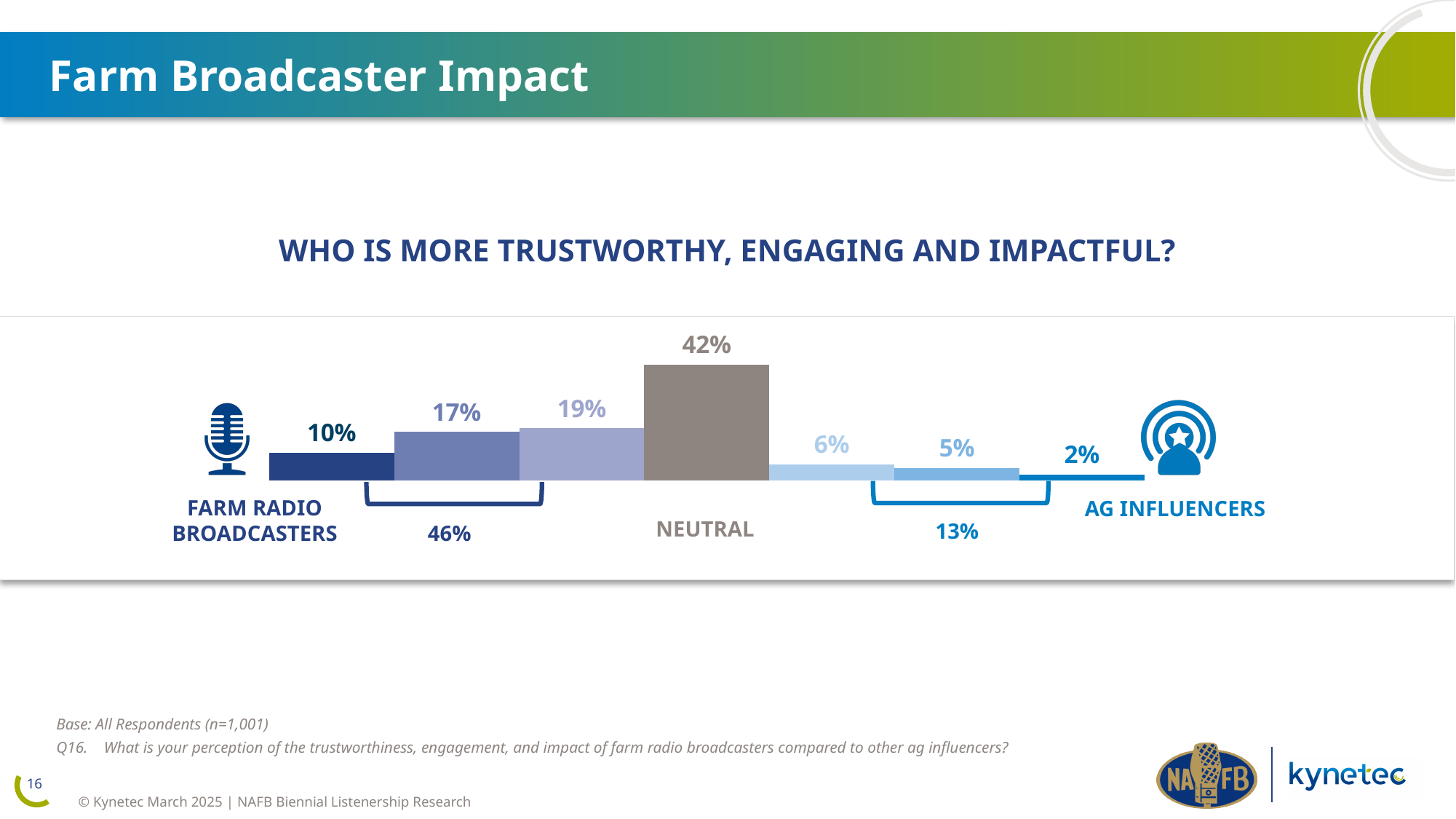
Which side has the larger combined share: Farm Radio Broadcasters or Ag Influencers? Farm Radio Broadcasters What kind of chart is shown on the slide? Bar chart Which bar has the highest value? Neutral (42%) What is the title of the chart? WHO IS MORE TRUSTWORTHY, ENGAGING AND IMPACTFUL? What is the value of the bar closest to the Farm Radio Broadcasters label? 10% What combined percentage leans toward Farm Radio Broadcasters, as shown by the bracket on the left? 46% How many bars are plotted in the chart? 7 What is the difference between the combined share leaning toward Farm Radio Broadcasters and the combined share leaning toward Ag Influencers? 33 percentage points What is the lowest value shown on any bar? 2% What combined percentage leans toward Ag Influencers, as shown by the bracket on the right? 13% What percentage of respondents are shown as Neutral? 42% What is the value of the bar closest to the Ag Influencers label? 2%